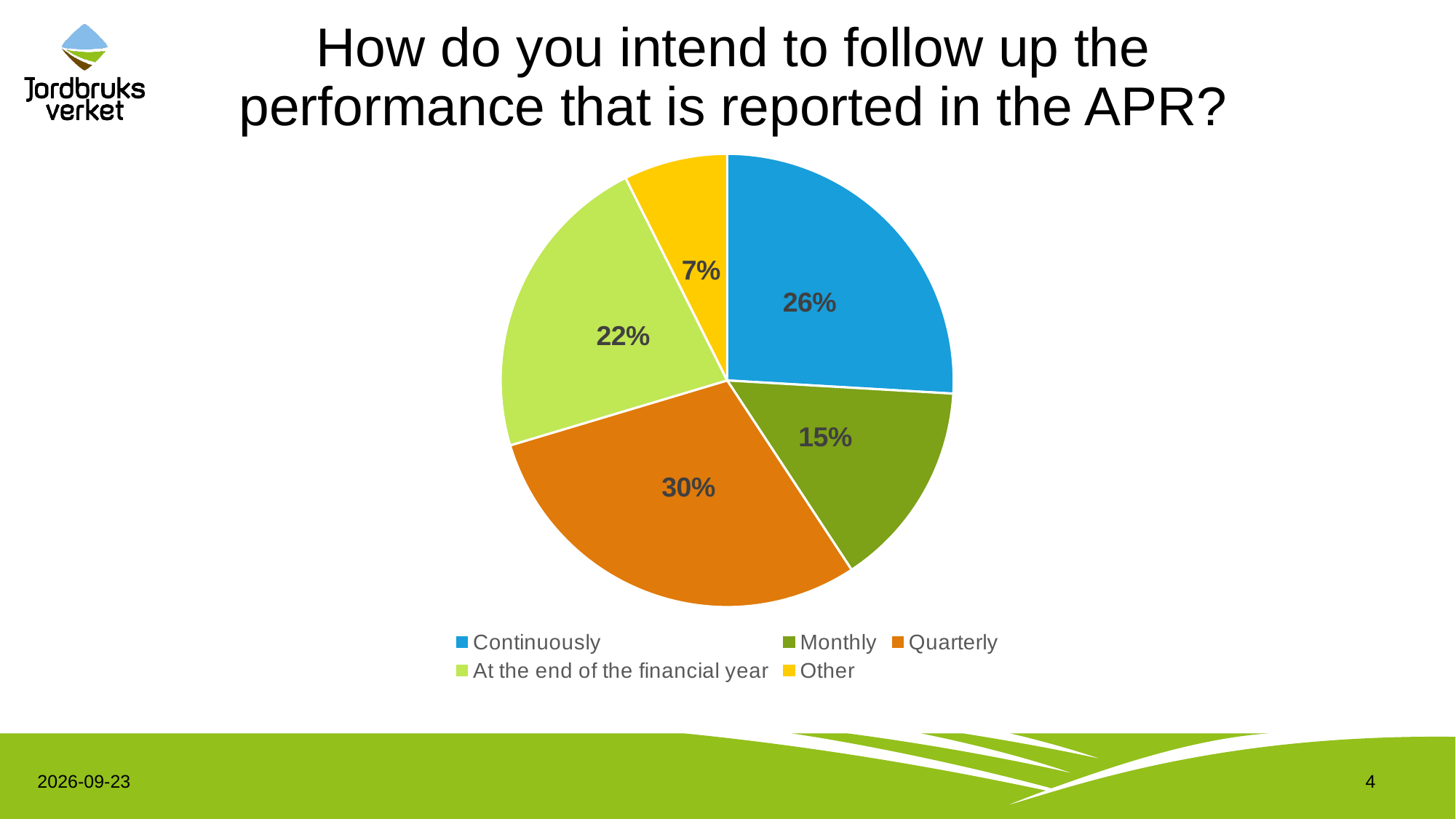
Which is larger, Continuously or At the end of the financial year? Continuously What share of the pie does Other represent? 7% What share of the pie does At the end of the financial year represent? 22% What share of the pie does Monthly represent? 15% What kind of chart is shown on the slide? Pie chart Which category has the smallest slice of the pie? Other What share of the pie does Quarterly represent? 30% How many categories are shown in the pie chart? 5 Which category has the largest slice of the pie? Quarterly What colour is the Quarterly slice? Orange What share of the pie does Continuously represent? 26% What is the difference in percentage points between Quarterly and Monthly? 15